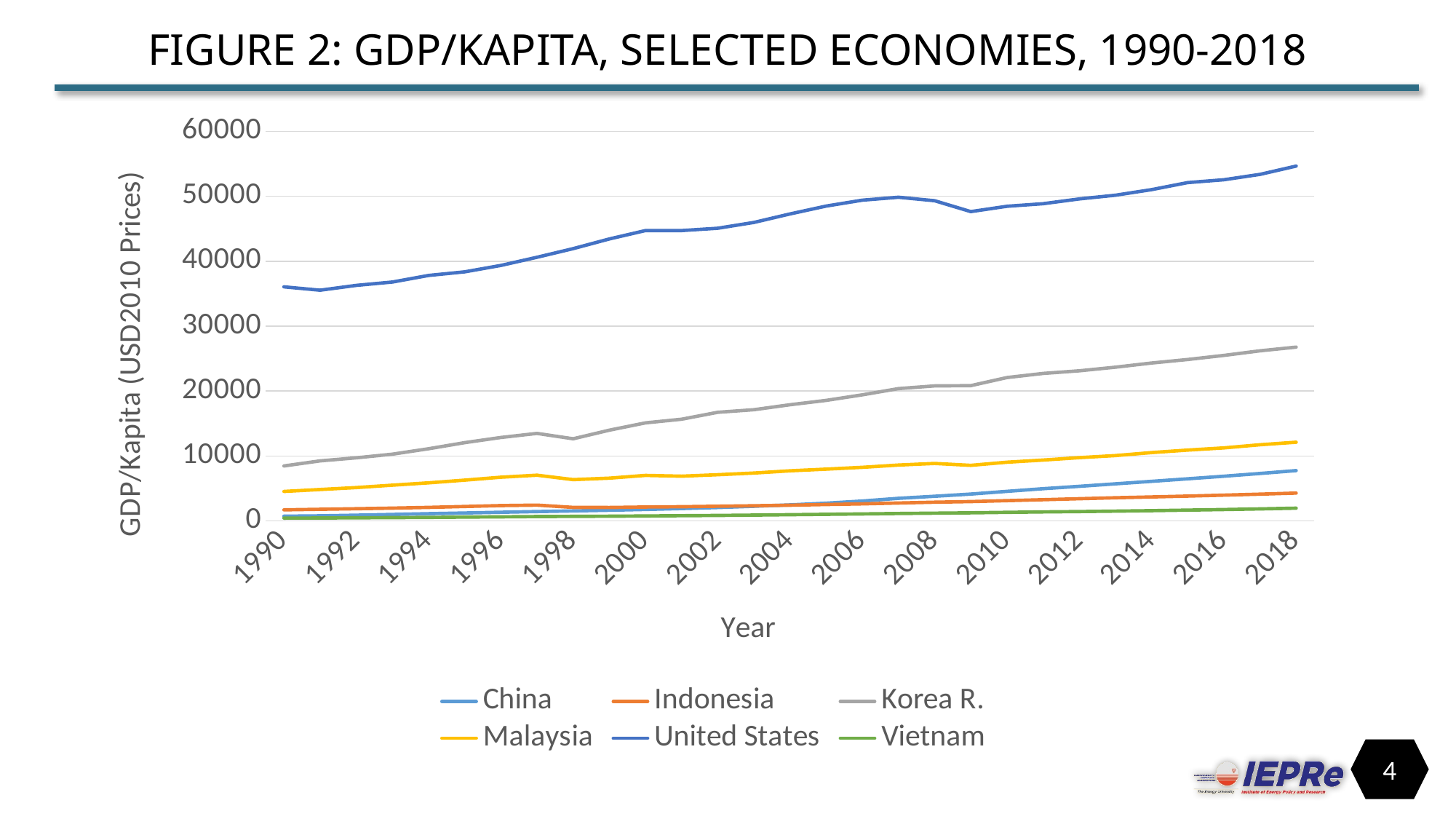
What kind of chart is shown on the slide? line chart Which economy has the lowest GDP/Kapita in 2018? Vietnam How many series does the legend list? 6 Is the value for United States in 1990 greater or less than 40000? less Does the United States line generally rise or fall from 1990 to 2018? rise Is the value for Korea R. in 2018 greater or less than 20000? greater Is the value for United States in 2018 greater or less than 50000? greater Which is larger in 1990, the value for Indonesia or the value for China? Indonesia What is the label on the vertical axis? GDP/Kapita (USD2010 Prices) Which is larger in 2018, the value for Malaysia or the value for China? Malaysia Which economy has the highest GDP/Kapita in 2018? United States